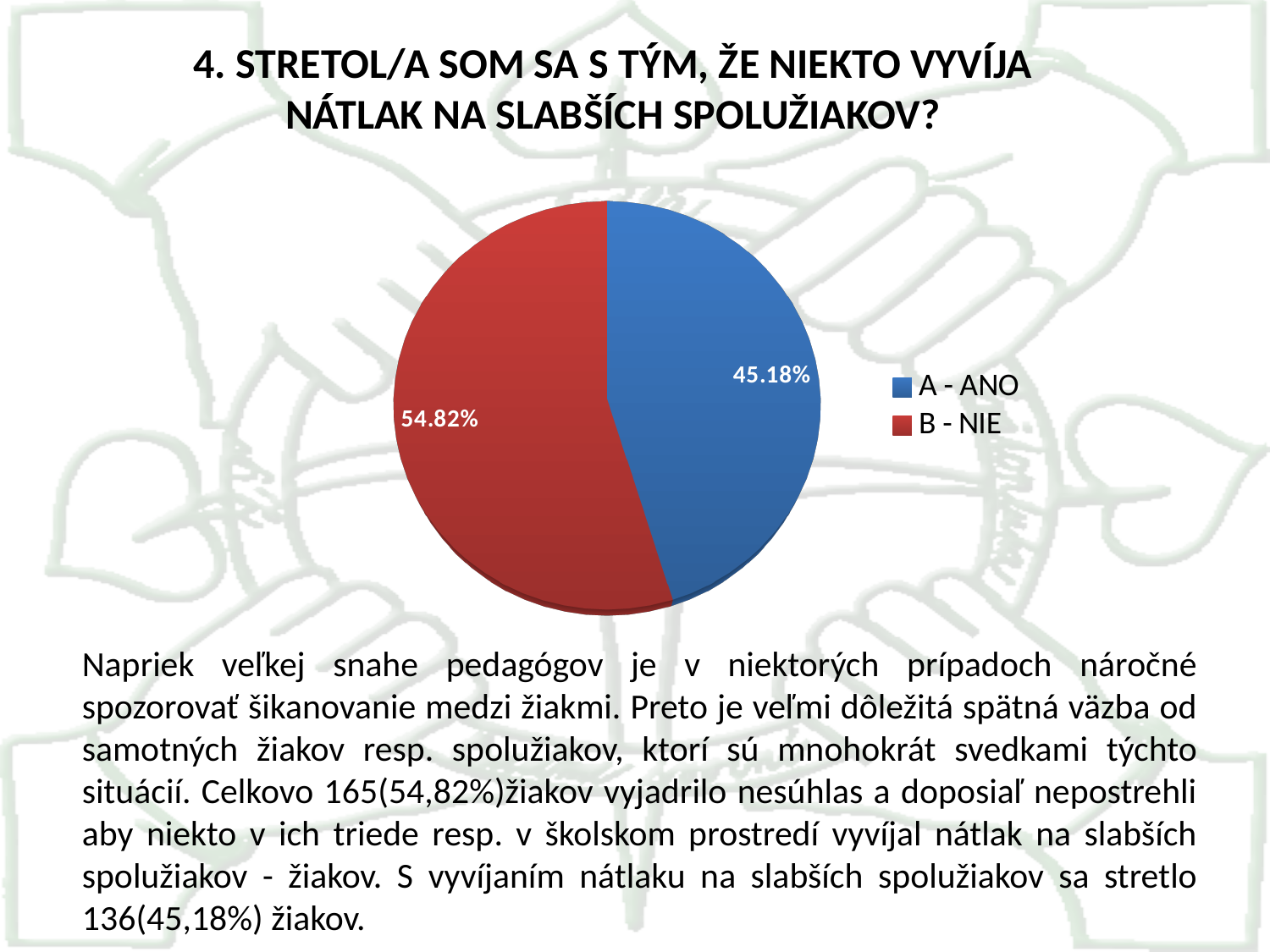
What colour is the "B - NIE" slice? red What colour is the "A - ANO" slice? blue Is the share for "A - ANO" greater or less than 50%? less What share of the pie does the slice "B - NIE" represent? 54.82% What share of the pie does the slice "A - ANO" represent? 45.18% How many slices does the pie chart have? 2 Which is larger, the "A - ANO" slice or the "B - NIE" slice? B - NIE What is the difference in percentage points between the "B - NIE" slice and the "A - ANO" slice? 9.64 How many entries does the legend list? 2 Which slice of the pie is the smallest? A - ANO Which slice of the pie is the largest? B - NIE What kind of chart is shown on the slide? pie chart